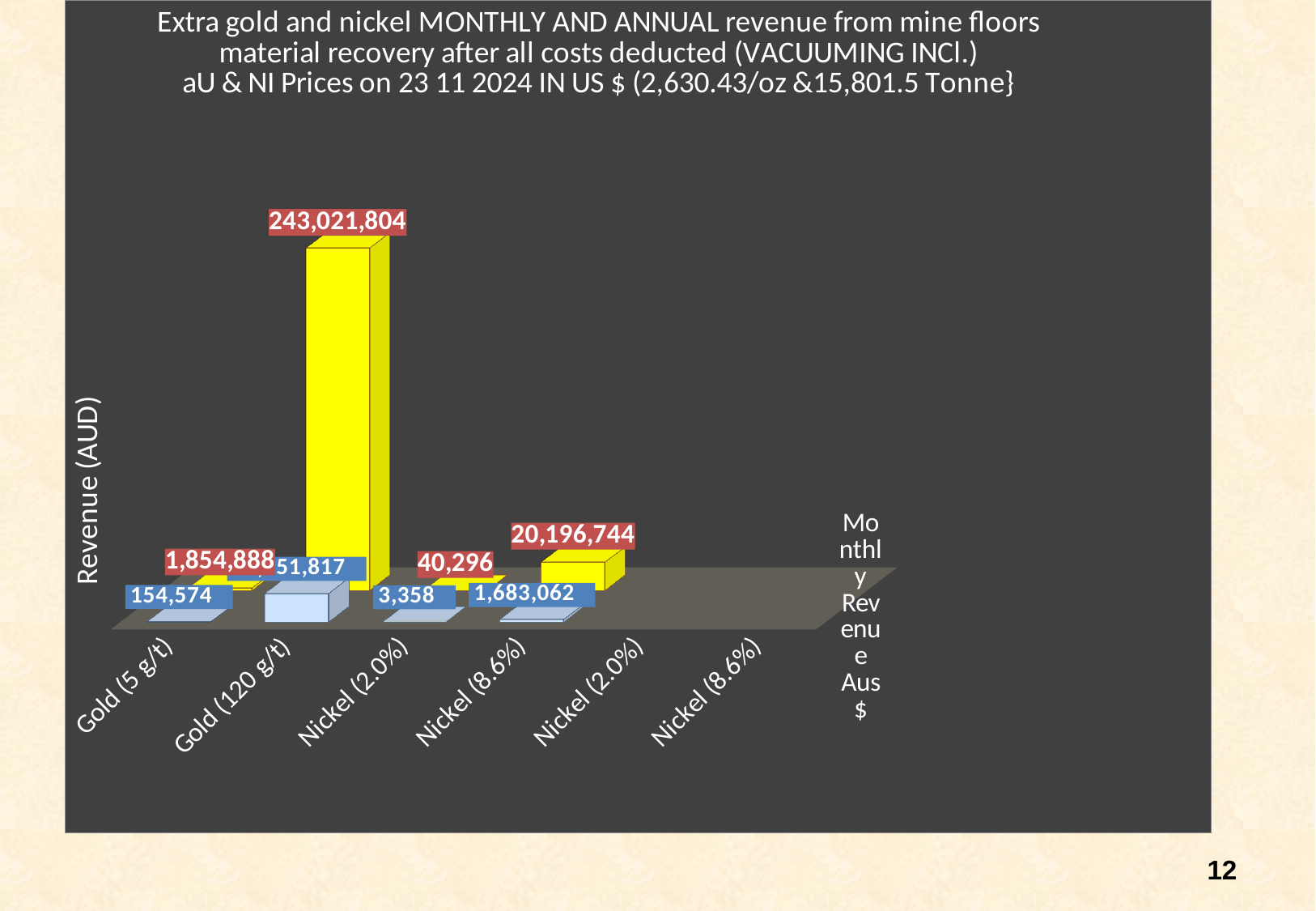
What is the title of the vertical axis? Revenue (AUD) What is the difference between the blue label values 1,683,062 and 154,574? 1,528,488 How many category labels are shown along the x axis? 6 What legend entry is shown to the right of the chart? Monthly Revenue Aus $ What is the value shown on the blue label for the Gold (5 g/t) category? 154,574 What kind of chart is shown on the slide? bar chart What is the smallest value labelled on the chart? 3,358 What is the largest value labelled on the chart? 243,021,804 What is the value shown on the red label above the Gold (5 g/t) category? 1,854,888 Which category has the tallest yellow bar? Gold (120 g/t) Which is larger, the labelled value 20,196,744 or the labelled value 1,854,888? 20,196,744 What is the difference between the red label value 1,854,888 and the blue label value 154,574 for Gold (5 g/t)? 1,700,314